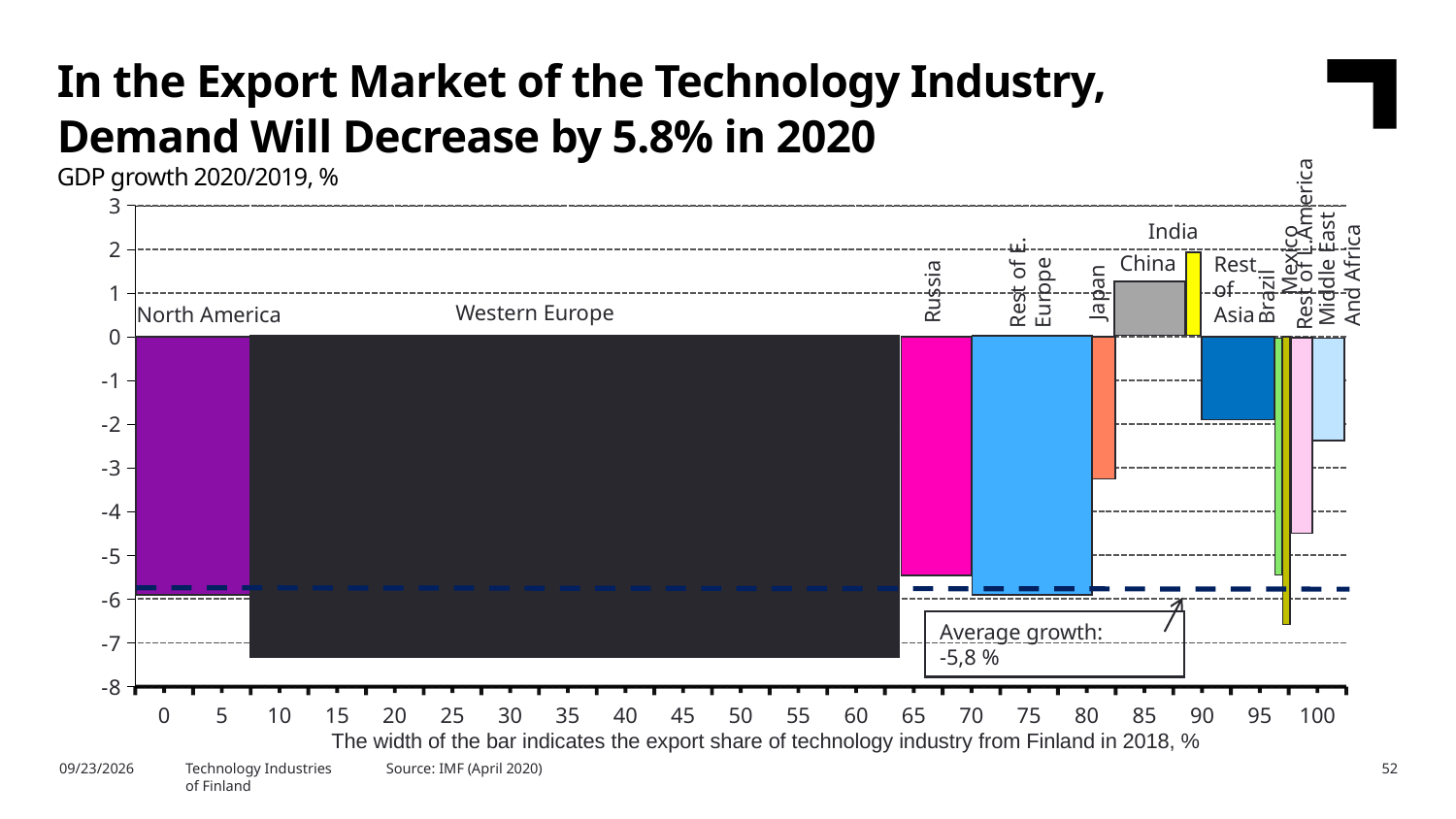
Which has the higher GDP growth, Rest of Asia or Middle East and Africa? Rest of Asia What average growth value is printed on the chart? -5,8 % According to the note below the chart, what does the width of each bar indicate? The export share of technology industry from Finland in 2018 Which region has the lowest GDP growth 2020/2019 in the chart? Western Europe Which region has the highest GDP growth 2020/2019 in the chart? India Is the GDP growth value for Mexico greater or less than -6? less How many regions are plotted as bars in the chart? 12 What kind of chart is shown on the slide? Bar chart Is the GDP growth value for China greater or less than 0? greater Is the GDP growth value for Western Europe greater or less than -7? less Which has the higher GDP growth, Brazil or Rest of L. America? Rest of L. America